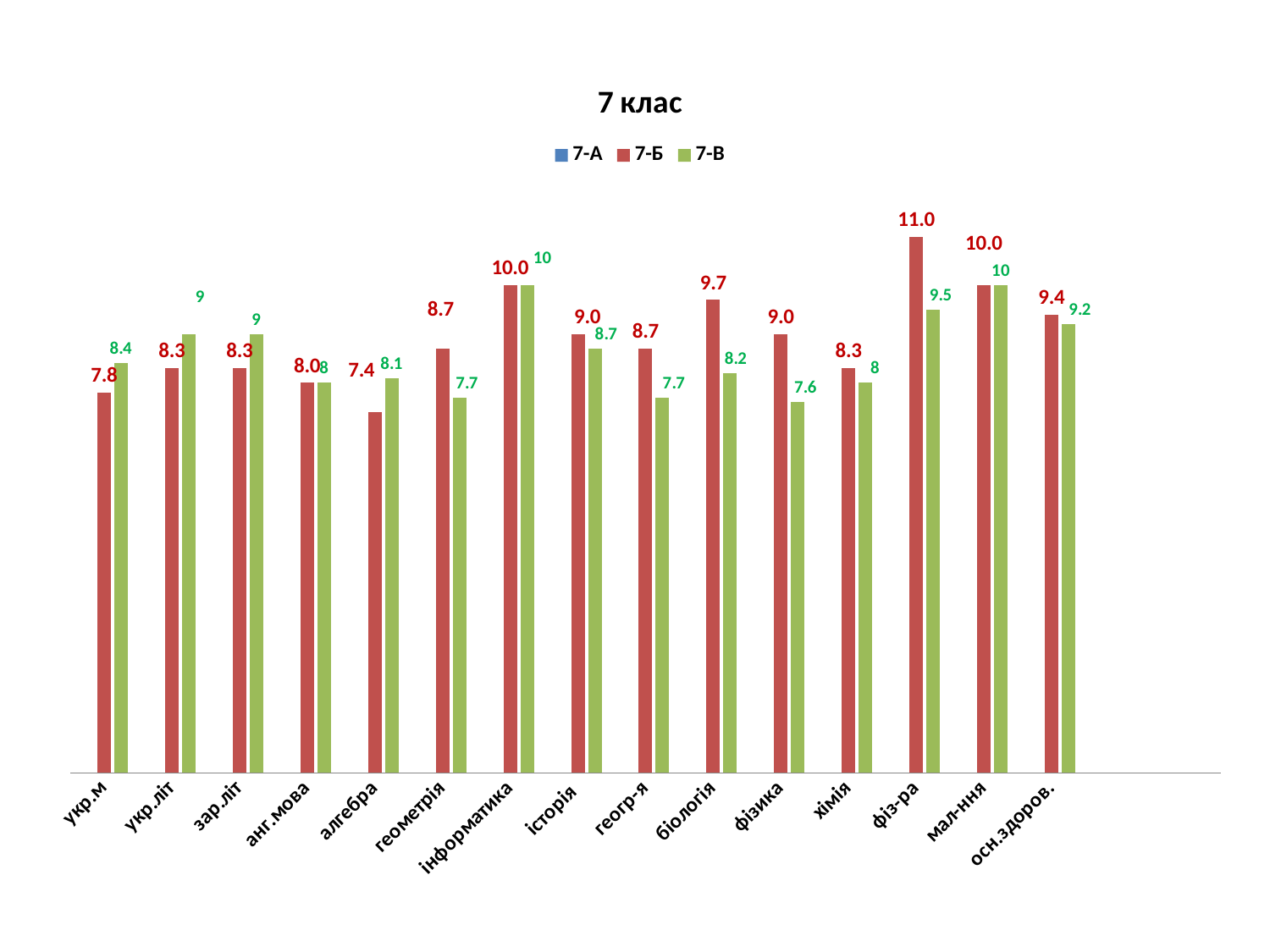
What is the title of the chart? 7 клас What is the value for 7-Б in алгебра? 7.4 Which is larger in геометрія, the value for 7-Б or for 7-В? 7-Б What is the value for 7-В in геометрія? 7.7 Which subject has the lowest value for 7-Б? алгебра Which subject has the highest value for 7-Б? фіз-ра What is the difference between the 7-Б and 7-В values in фіз-ра? 1.5 What is the value for 7-Б in біологія? 9.7 What is the value for 7-В in фіз-ра? 9.5 Which subject has the lowest value for 7-В? фізика How many series does the legend list? 3 How many subjects are shown on the x axis? 15